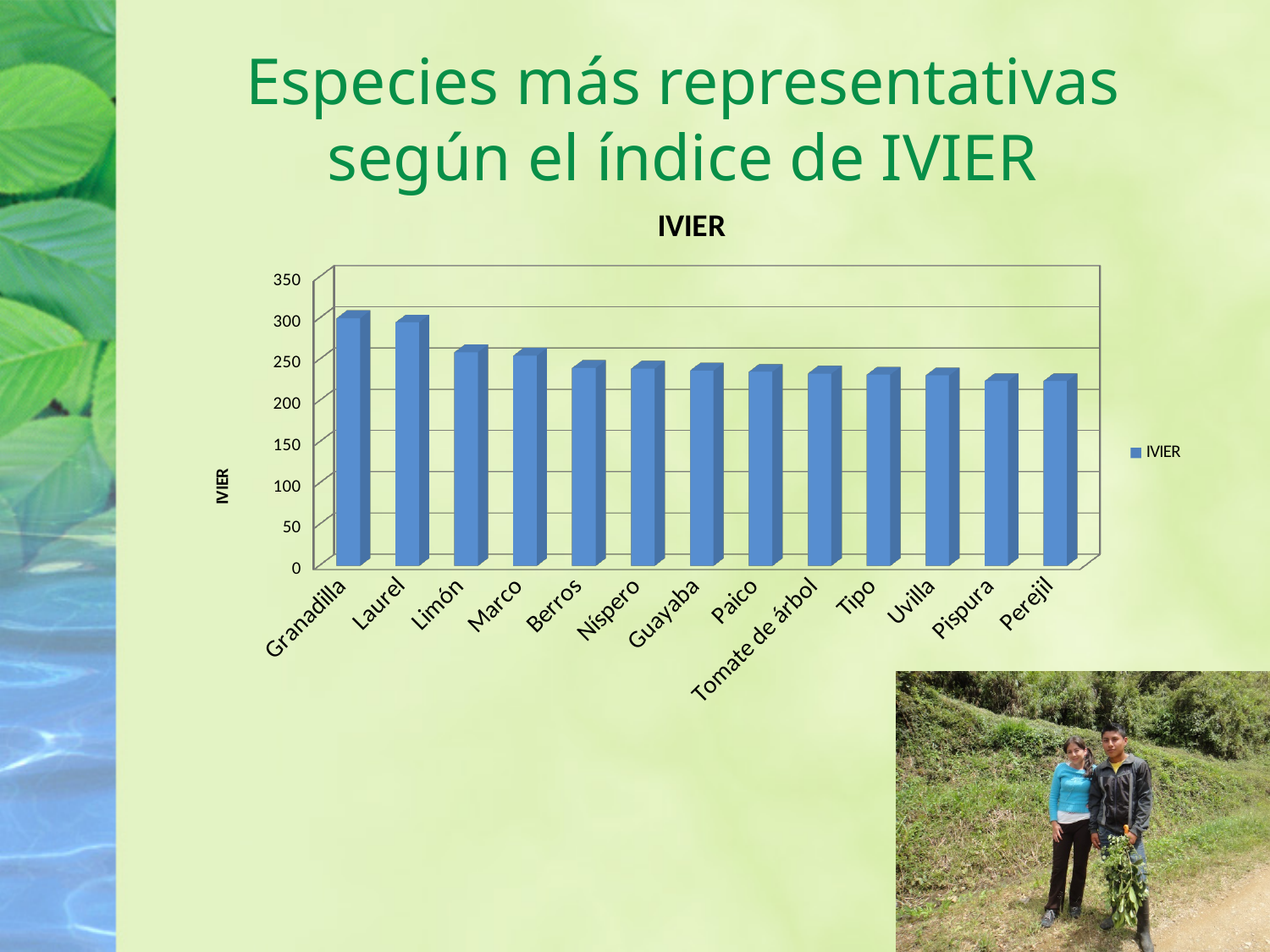
Is the IVIER value for Granadilla greater or less than 250? greater How many species (categories) are plotted on the chart? 13 Which has a higher IVIER value, Granadilla or Limón? Granadilla Which species has the highest IVIER value? Granadilla Is the IVIER value for Perejil greater or less than 250? less Which has a higher IVIER value, Limón or Perejil? Limón How many series does the legend list? 1 Do the IVIER values rise or fall from left to right along the x axis? fall What is the title of the chart? IVIER What type of chart is shown on the slide? bar chart Is the IVIER value for Berros greater or less than 300? less